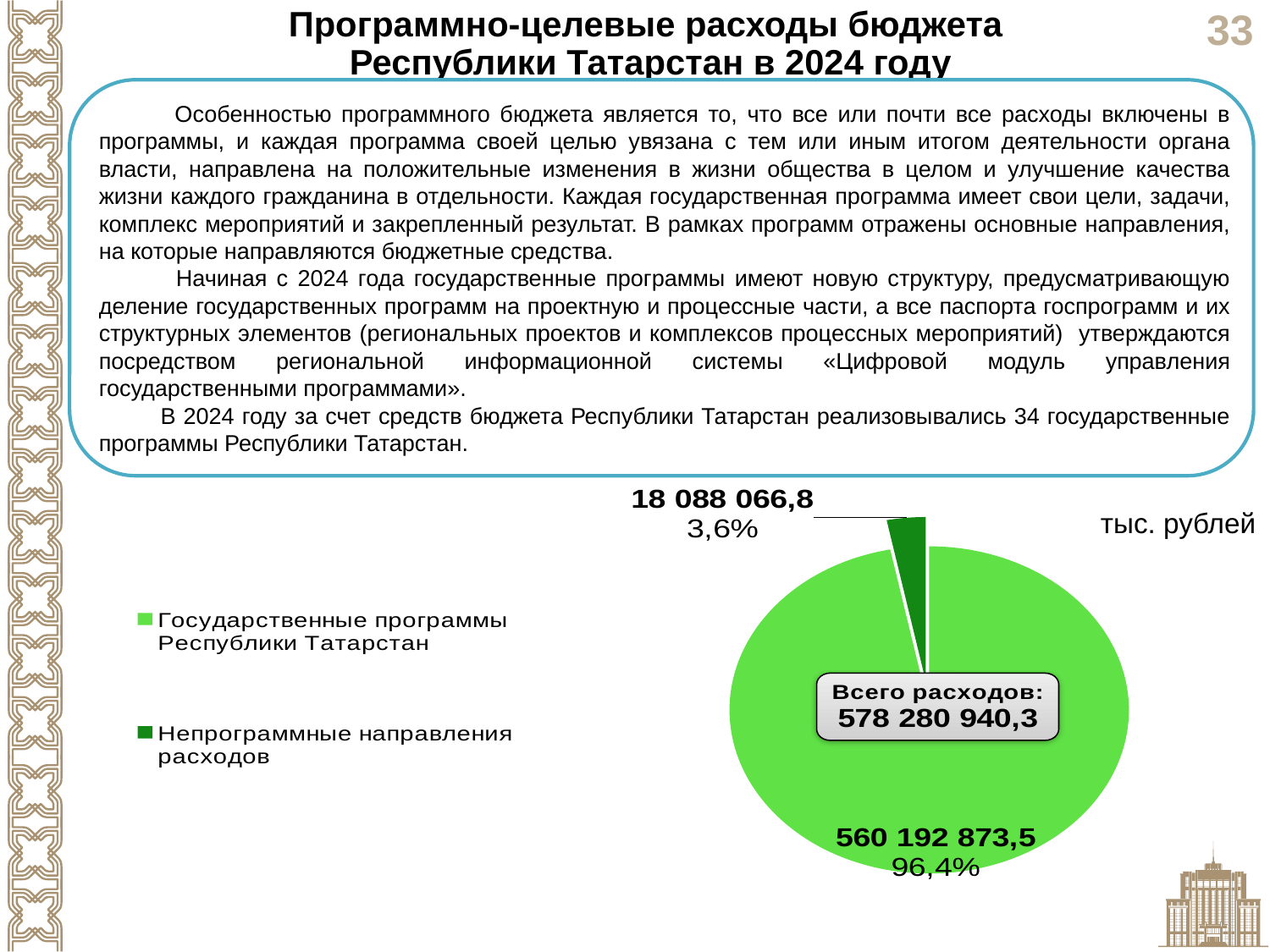
How many slices does the pie chart have? 2 What share of the pie does Государственные программы Республики Татарстан take? 96,4% What is the total of all expenditures (Всего расходов) shown in the centre of the pie chart? 578 280 940,3 What is the value for Государственные программы Республики Татарстан in the pie chart? 560 192 873,5 What share of the pie does Непрограммные направления расходов take? 3,6% Which is larger: Государственные программы Республики Татарстан or Непрограммные направления расходов? Государственные программы Республики Татарстан How many series does the legend of the pie chart list? 2 In what units are the values of the pie chart given? тыс. рублей Which slice of the pie chart is the smallest? Непрограммные направления расходов What kind of chart is shown on the slide? pie chart What is the value for Непрограммные направления расходов in the pie chart? 18 088 066,8 Which slice of the pie chart is the largest? Государственные программы Республики Татарстан